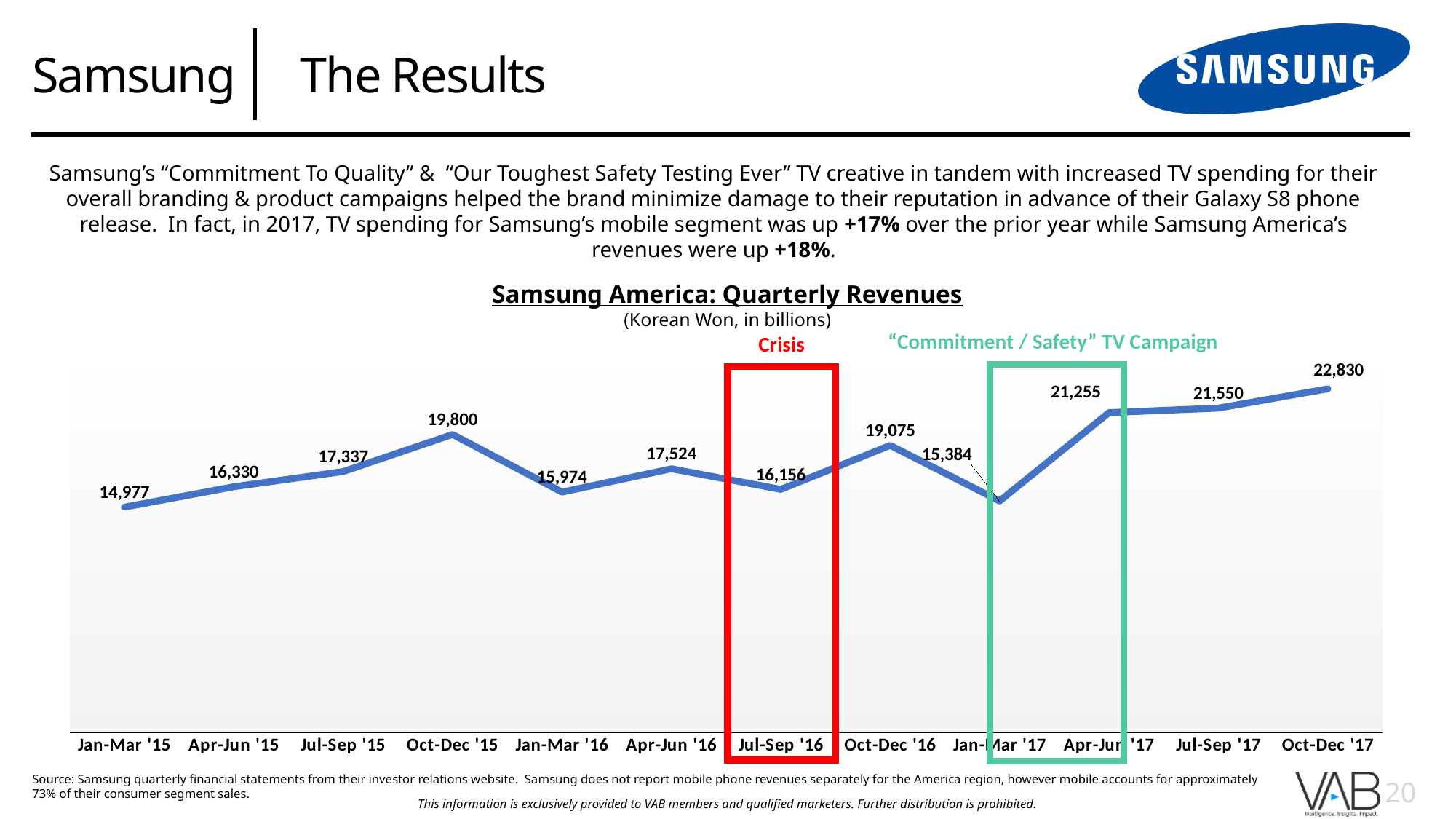
Did revenue rise or fall from Jan-Mar '17 to Oct-Dec '17? Rise Which quarter had the highest revenue? Oct-Dec '17 Which quarter had higher revenue, Oct-Dec '15 or Apr-Jun '17? Apr-Jun '17 What was Samsung America's quarterly revenue in Jul-Sep '16, the quarter marked as the Crisis? 16,156 Which quarter had the lowest revenue? Jan-Mar '15 What is the difference in revenue between Apr-Jun '17 and Jan-Mar '17? 5,871 In what unit are the revenues on the chart expressed? Korean Won, in billions What is the difference in revenue between Oct-Dec '15 and Oct-Dec '16? 725 How many quarters are plotted on the chart? 12 What was Samsung America's quarterly revenue in Jan-Mar '15? 14,977 What type of chart is shown on the slide? Line chart What was Samsung America's quarterly revenue in Oct-Dec '17? 22,830